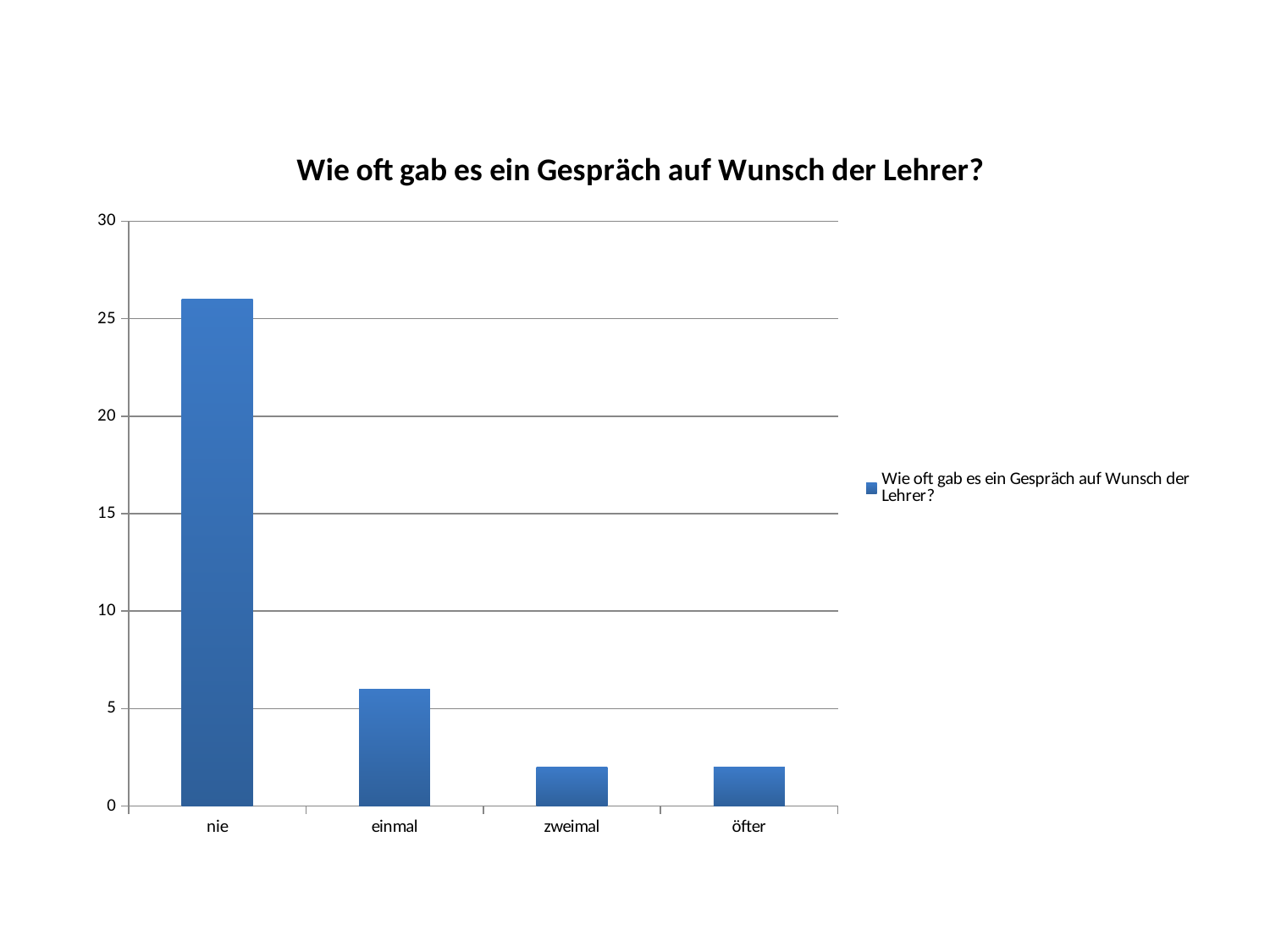
Which is larger, the value for nie or the value for einmal? nie Which is larger, the value for einmal or the value for zweimal? einmal How many series does the legend list? 1 Do the values generally rise or fall from nie to öfter along the x axis? fall Is the value for zweimal greater or less than 5? less How many categories are shown on the x axis? 4 What is the title of the chart? Wie oft gab es ein Gespräch auf Wunsch der Lehrer? Is the value for einmal greater or less than 10? less Which category has the highest value? nie Is the value for öfter greater or less than 5? less What kind of chart is shown on the slide? bar chart